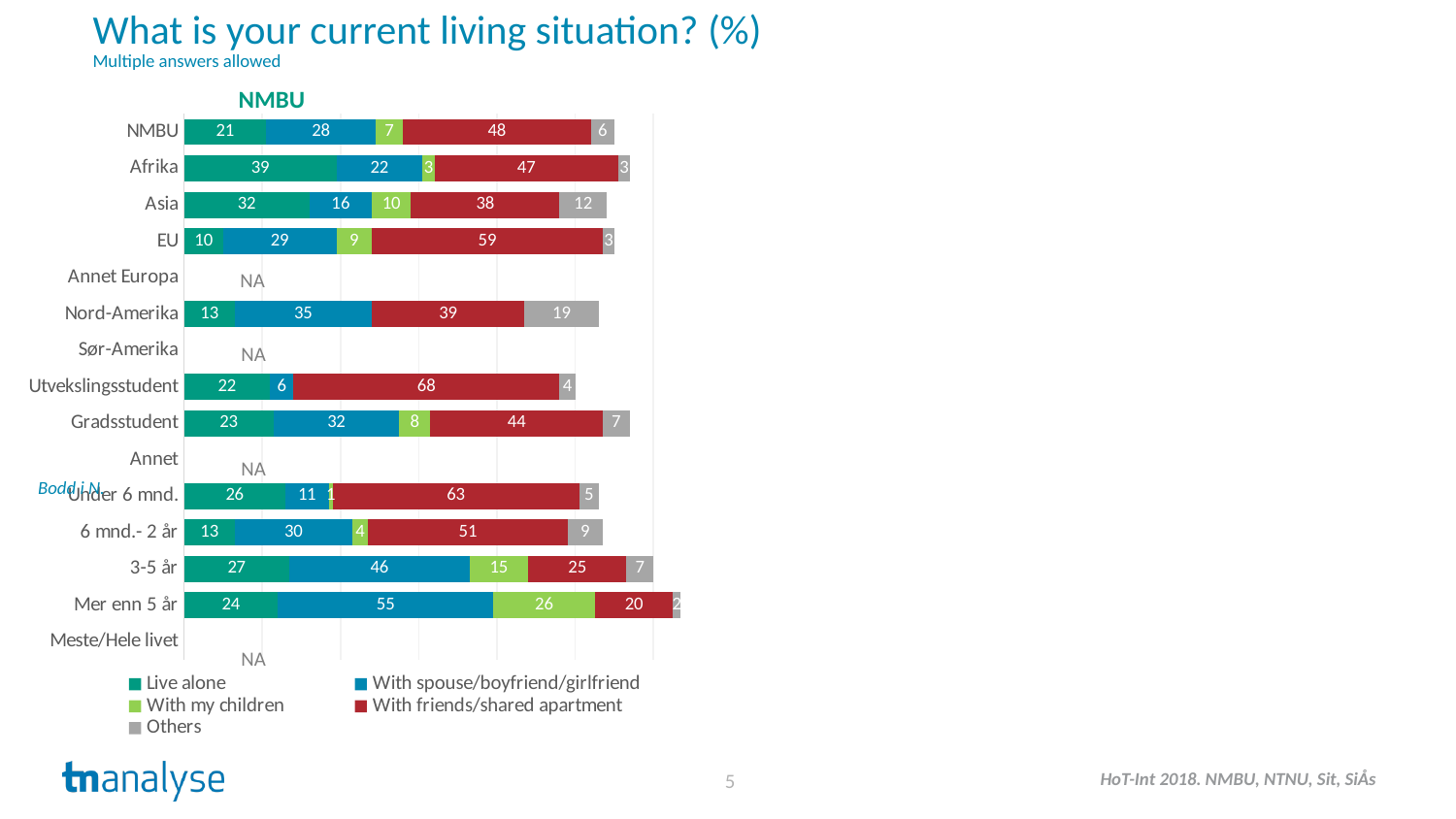
How many rows in the chart are marked NA? 4 What is the value for 'Others' in the Nord-Amerika row? 19 What is the difference between the 'With spouse/boyfriend/girlfriend' values for '3-5 år' and 'Under 6 mnd.'? 35 What kind of chart is shown on the slide? Stacked bar chart Which row has the lowest value for 'Live alone'? EU Which row has the highest value for 'With friends/shared apartment'? Utvekslingsstudent What is the total of the stacked bar for the NMBU row? 110 How many series does the legend list? 5 What is the value for 'With friends/shared apartment' in the EU row? 59 What is the value for 'Live alone' in the Afrika row? 39 What is the value for 'With spouse/boyfriend/girlfriend' in the 'Mer enn 5 år' row? 55 Which is larger: the 'With my children' value for 'Mer enn 5 år' or for Asia? Mer enn 5 år